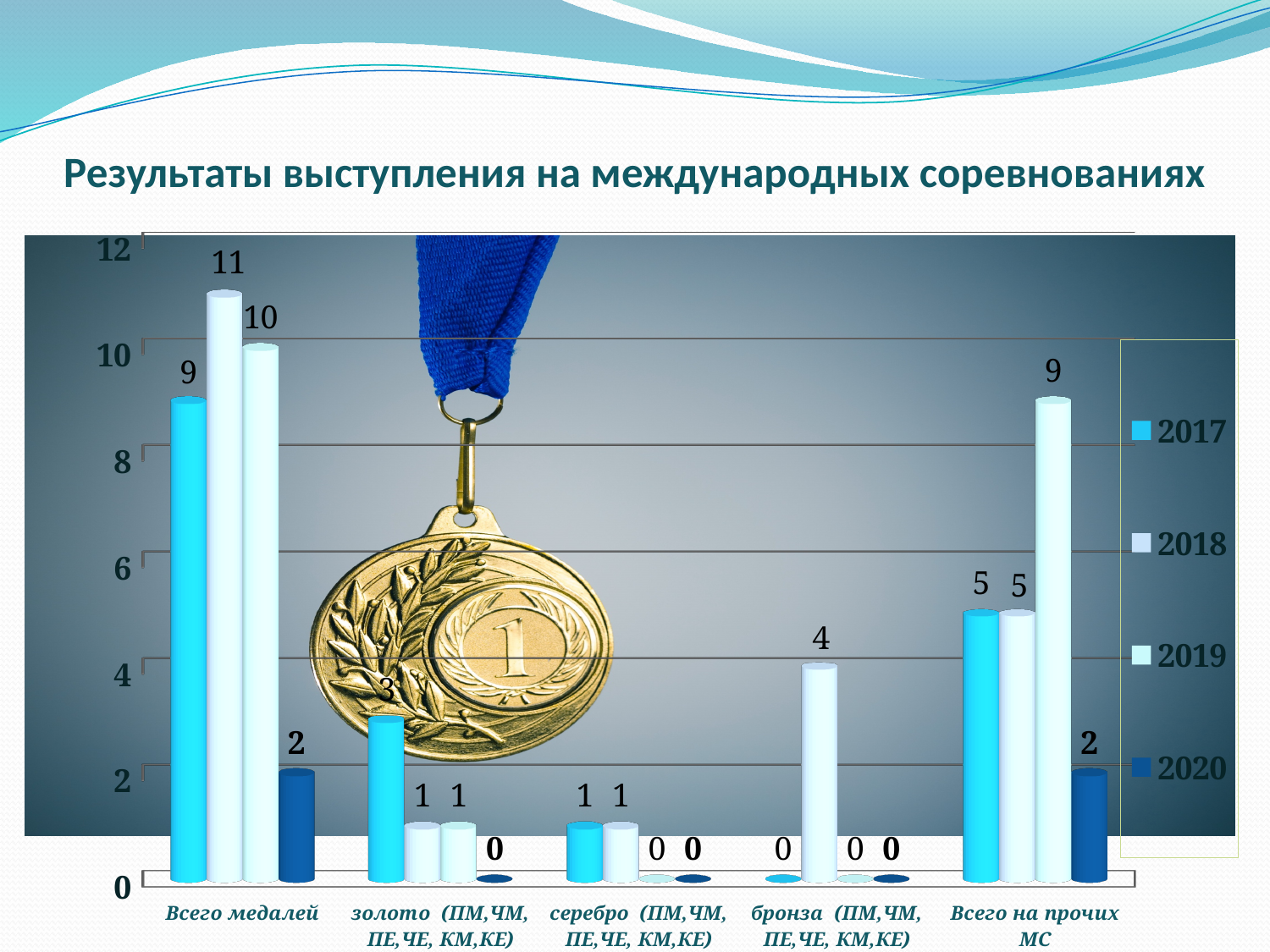
In the category 'Всего на прочих МС', which is larger: the value for 2019 or the value for 2017? 2019 What is the title of the chart? Результаты выступления на международных соревнованиях What is the value for 2018 in the category 'бронза (ПМ,ЧМ, ПЕ,ЧЕ, КМ,КЕ)'? 4 What type of chart is shown on the slide? bar chart How many categories are shown on the x axis? 5 Which year has the highest value in the category 'Всего медалей'? 2018 What is the value for 2019 in the category 'Всего на прочих МС'? 9 How many series does the legend list? 4 What is the difference between the 2018 and 2020 values in the category 'Всего медалей'? 9 What is the value for 2017 in the category 'золото (ПМ,ЧМ, ПЕ,ЧЕ, КМ,КЕ)'? 3 What is the value for 2018 in the category 'Всего медалей'? 11 Which year has the lowest value in the category 'Всего на прочих МС'? 2020